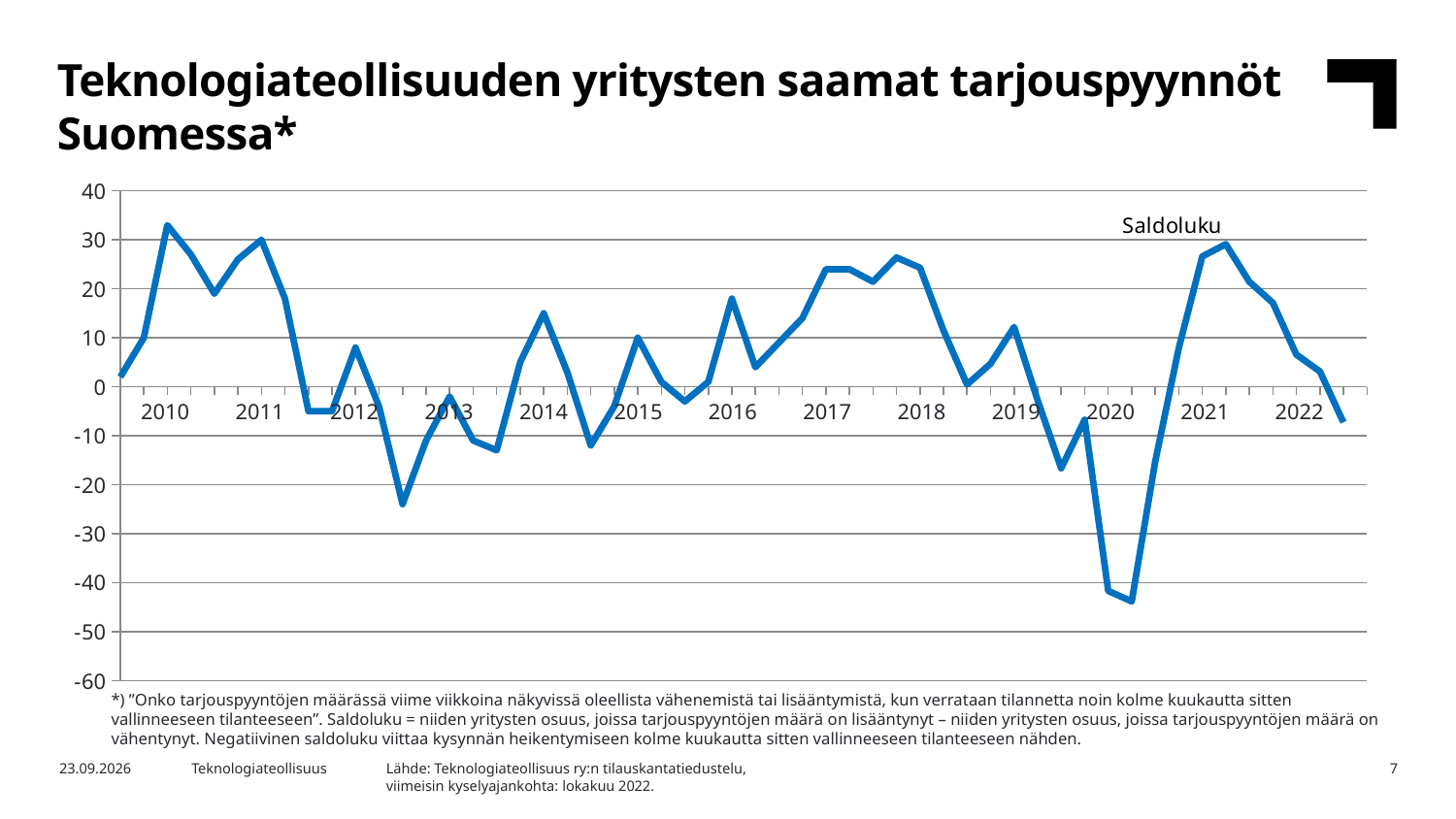
Is the peak value of the line in 2010 greater or less than 30? greater Is the value of the line at the start of 2017 greater or less than 20? less How many series does the chart plot? 1 Is the value of the line at the end of 2022 greater or less than 0? less Does the line rise or fall from the start of 2021 to the end of 2022? fall How many year labels are shown on the x axis? 13 In which year does the line reach its lowest point? 2020 What kind of chart is shown on the slide? line chart What is the lowest value shown on the y axis? -60 What is the name of the series plotted in the chart? Saldoluku